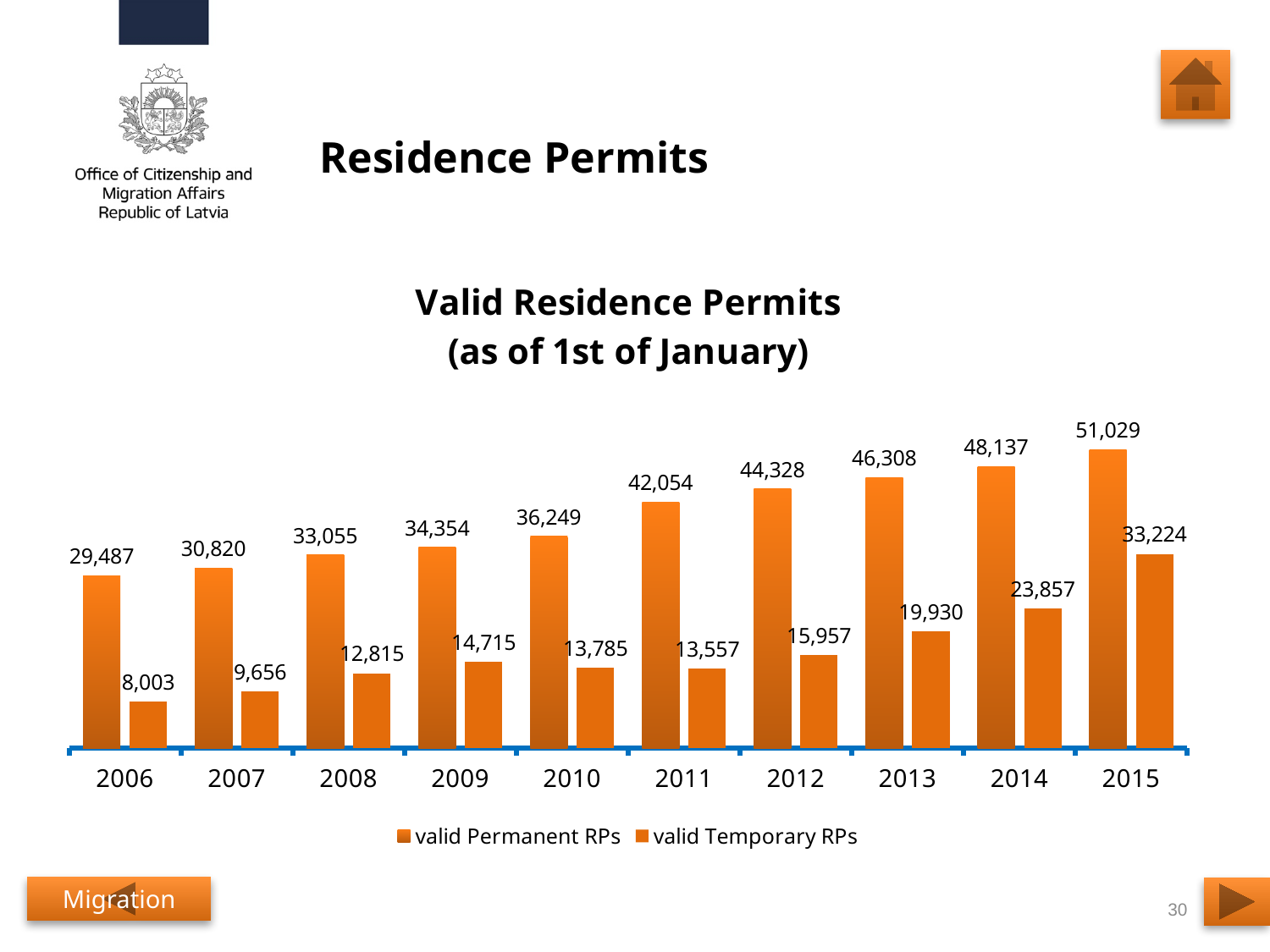
How many series does the legend list? 2 What kind of chart is shown on the slide? Bar chart Do the values for valid Permanent RPs rise or fall from 2006 to 2015? Rise Which year has the lowest value for valid Temporary RPs? 2006 What is the difference between valid Permanent RPs and valid Temporary RPs in 2012? 28,371 What is the value for valid Temporary RPs in 2013? 19,930 Which year has the highest value for valid Permanent RPs? 2015 What is the difference between valid Permanent RPs in 2015 and in 2014? 2,892 What is the value for valid Temporary RPs in 2006? 8,003 Which is larger: valid Temporary RPs in 2011 or in 2010? 2010 What is the value for valid Permanent RPs in 2010? 36,249 How many years are shown on the x axis? 10